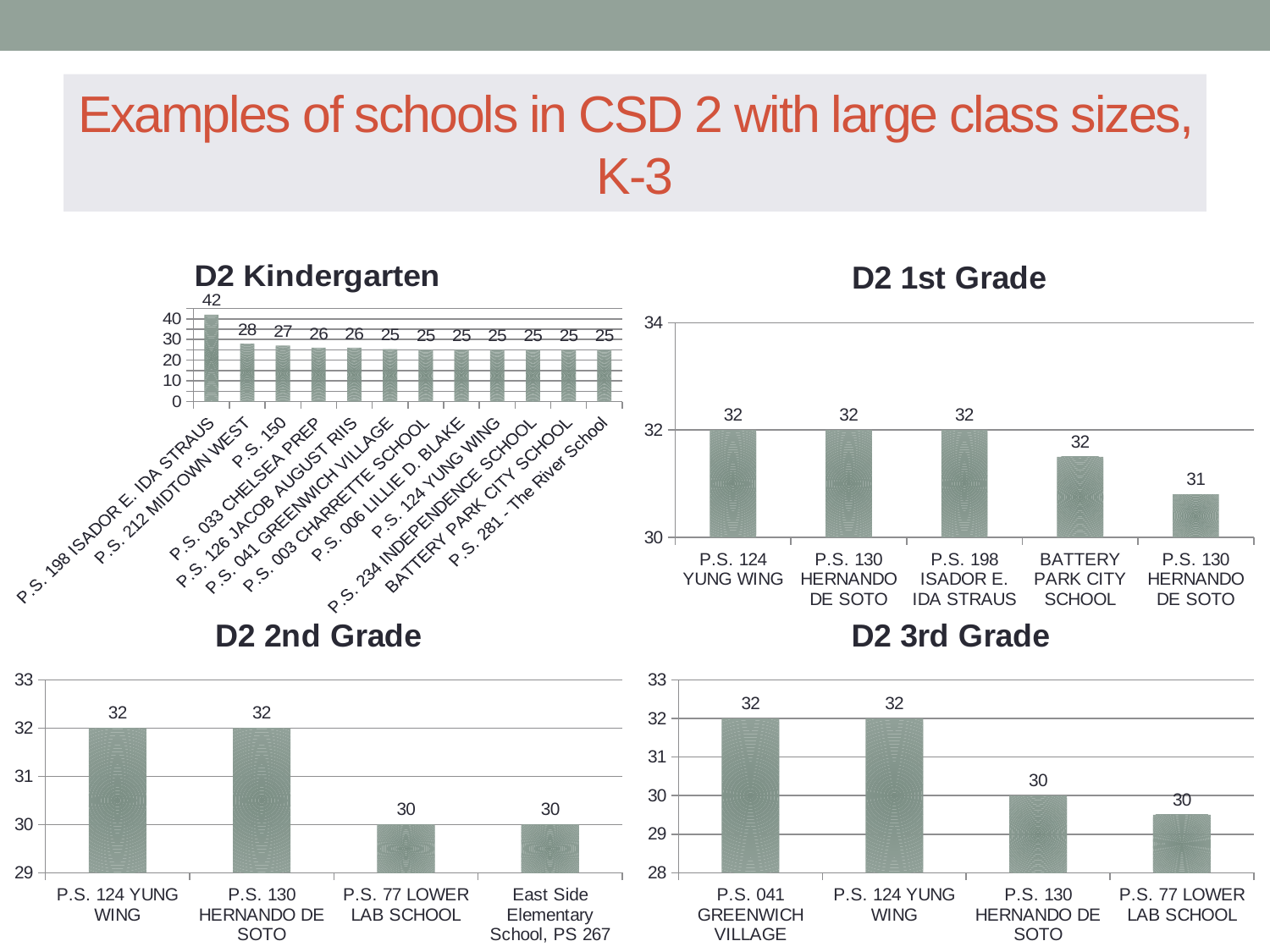
In the D2 3rd Grade chart, what is the difference between P.S. 124 YUNG WING and P.S. 130 HERNANDO DE SOTO? 2 In the D2 3rd Grade chart, what is the value for P.S. 041 GREENWICH VILLAGE? 32 In the D2 2nd Grade chart, what is the value for P.S. 77 LOWER LAB SCHOOL? 30 In the D2 2nd Grade chart, which is larger, P.S. 124 YUNG WING or East Side Elementary School, PS 267? P.S. 124 YUNG WING How many schools are shown in the D2 Kindergarten chart? 12 What type of chart is the D2 3rd Grade chart? Bar chart In the D2 Kindergarten chart, what is the value for P.S. 198 ISADOR E. IDA STRAUS? 42 In the D2 Kindergarten chart, what is the difference between P.S. 198 ISADOR E. IDA STRAUS and P.S. 150? 15 How many bars are in the D2 1st Grade chart? 5 In the D2 1st Grade chart, what is the value for P.S. 198 ISADOR E. IDA STRAUS? 32 In the D2 Kindergarten chart, what is the value for P.S. 212 MIDTOWN WEST? 28 In the D2 Kindergarten chart, which school has the highest value? P.S. 198 ISADOR E. IDA STRAUS